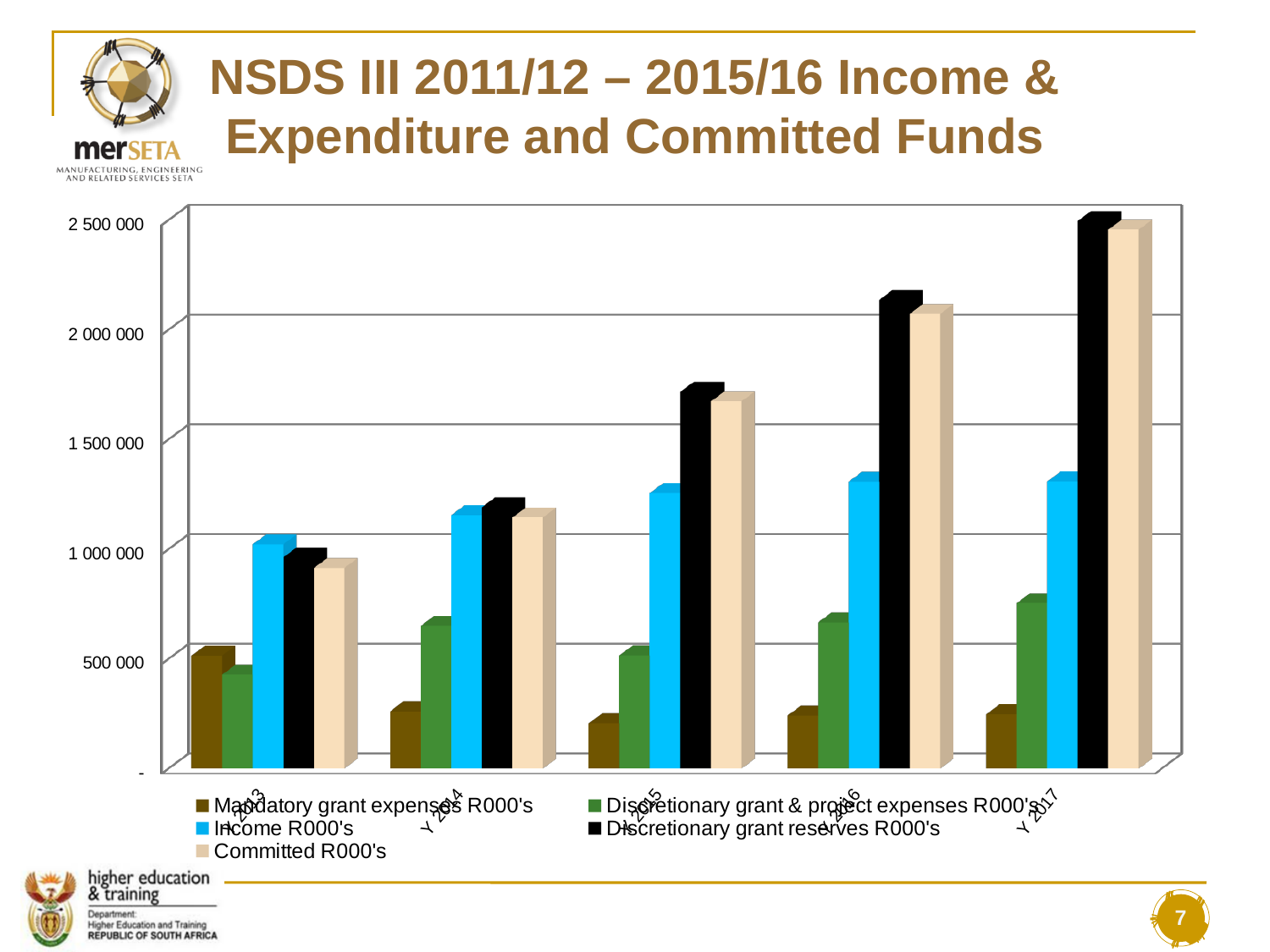
In Y 2017, which is larger: Income R000's or Discretionary grant reserves R000's? Discretionary grant reserves R000's What kind of chart is shown on the slide? Bar chart What colour represents Committed R000's in the legend? Beige Which series has the highest value in Y 2017? Discretionary grant reserves R000's Which series has the lowest value in Y 2017? Mandatory grant expenses R000's How many year categories are plotted along the x axis? 5 In which year is the value for Discretionary grant reserves R000's lowest? Y 2013 How many series does the legend list? 5 Is the value for Discretionary grant & project expenses R000's in Y 2017 greater or less than 500 000? greater Do the values for Discretionary grant reserves R000's rise or fall from Y 2013 to Y 2017? Rise Is the value for Discretionary grant reserves R000's in Y 2017 greater or less than 2 000 000? greater Is the value for Mandatory grant expenses R000's in Y 2014 greater or less than 500 000? less